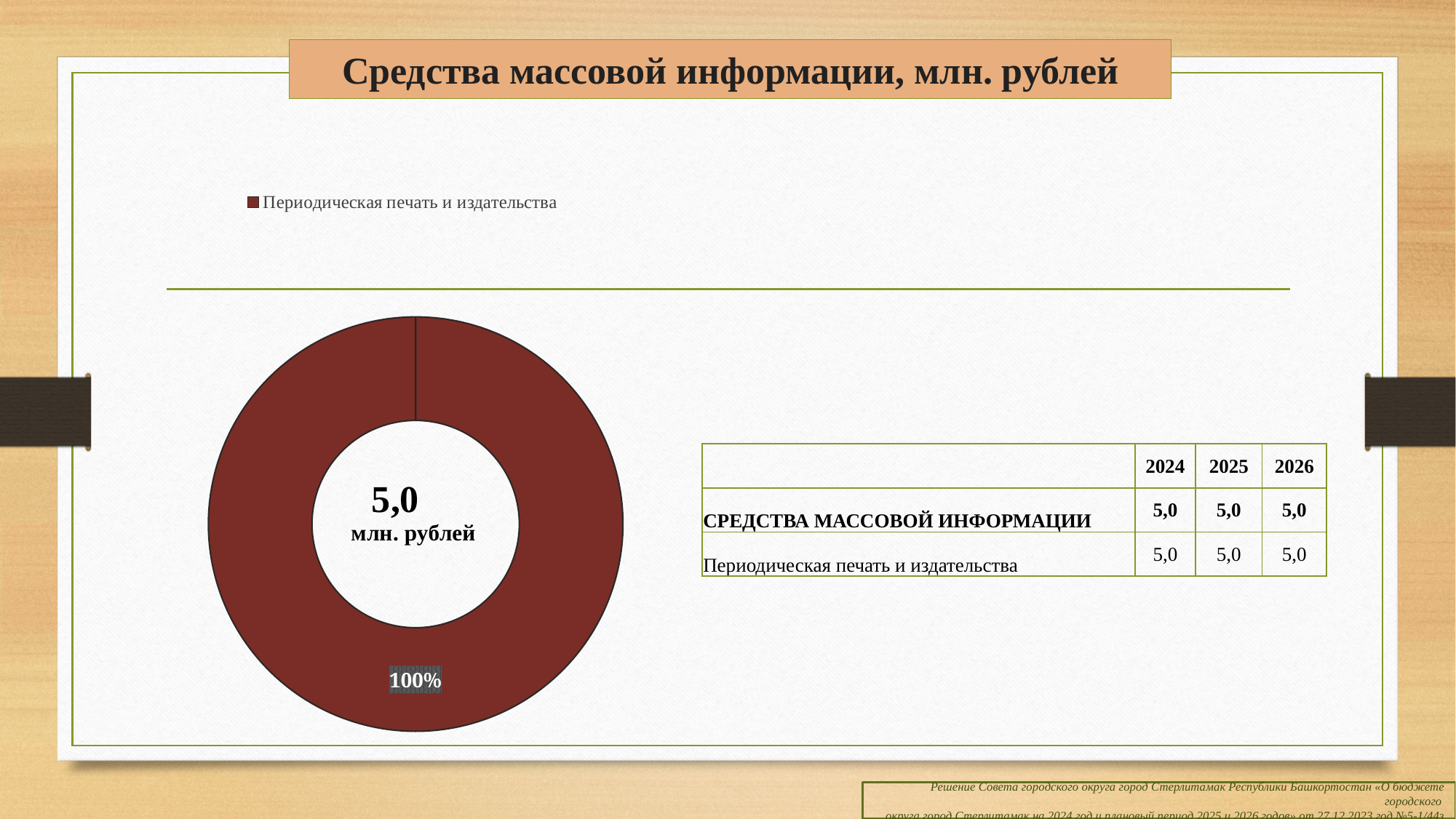
How many entries does the chart legend list? 1 How many slices does the doughnut chart have? 1 What share of the doughnut chart does the slice 'Периодическая печать и издательства' take? 100% What is the name of the only category shown in the chart legend? Периодическая печать и издательства Is the share of the slice 'Периодическая печать и издательства' greater or less than 50%? greater What value is printed in the centre of the doughnut chart? 5,0 млн. рублей What is the percentage label printed on the doughnut slice? 100% What kind of chart is shown on the slide? doughnut (pie) chart What is the title of the slide above the chart? Средства массовой информации, млн. рублей